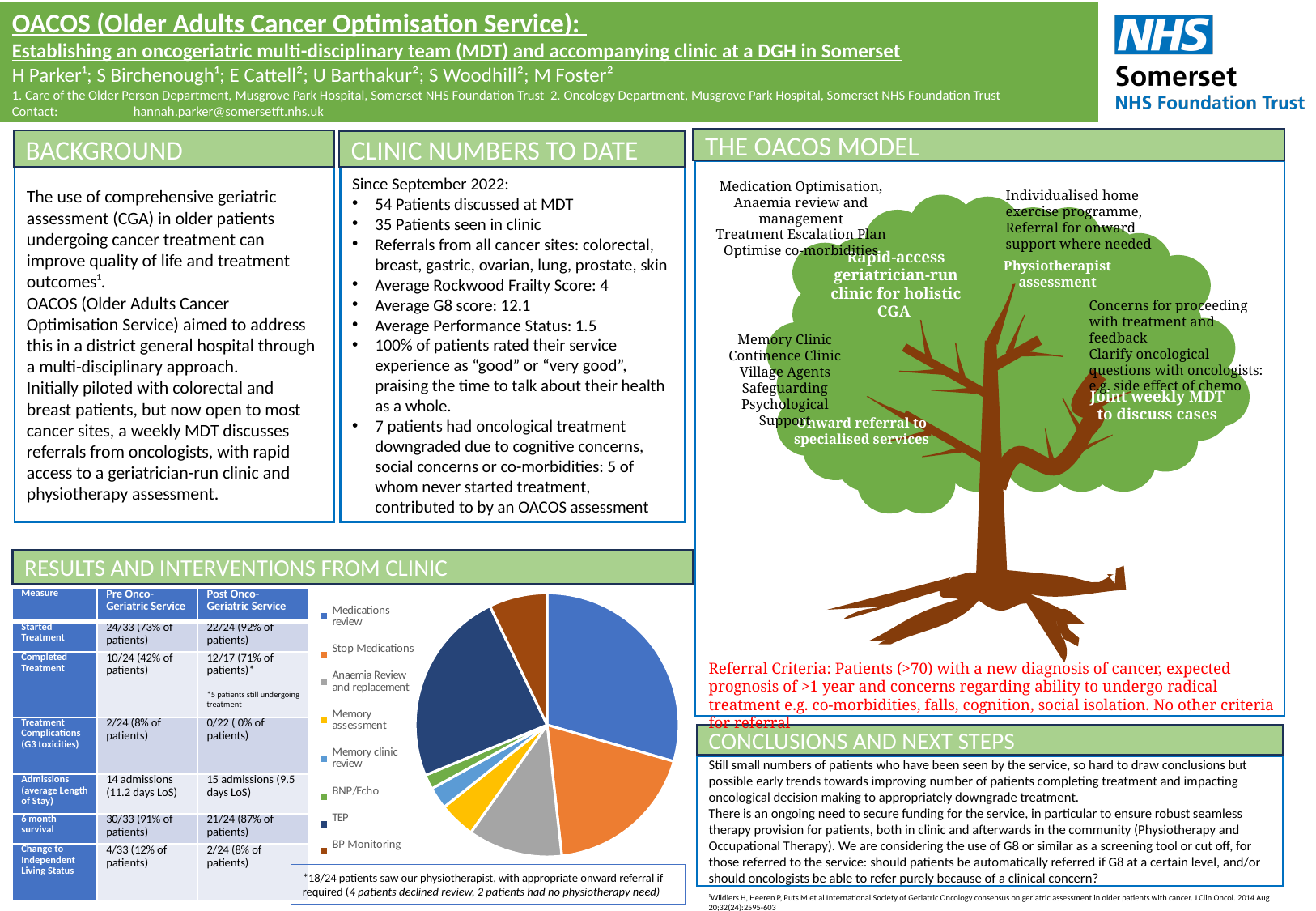
In the pie chart, which is larger: Stop Medications or Anaemia Review and replacement? Stop Medications What kind of chart is shown in the Results and Interventions from Clinic section? pie chart Which category has the largest slice in the pie chart? Medications review How many slices does the pie chart have? 8 In the pie chart, which is larger: TEP or BP Monitoring? TEP In the pie chart, which is larger: Anaemia Review and replacement or Memory assessment? Anaemia Review and replacement How many categories does the legend of the pie chart list? 8 Which legend entry in the pie chart is shown in brown? BP Monitoring What colour is the Medications review slice in the pie chart? blue